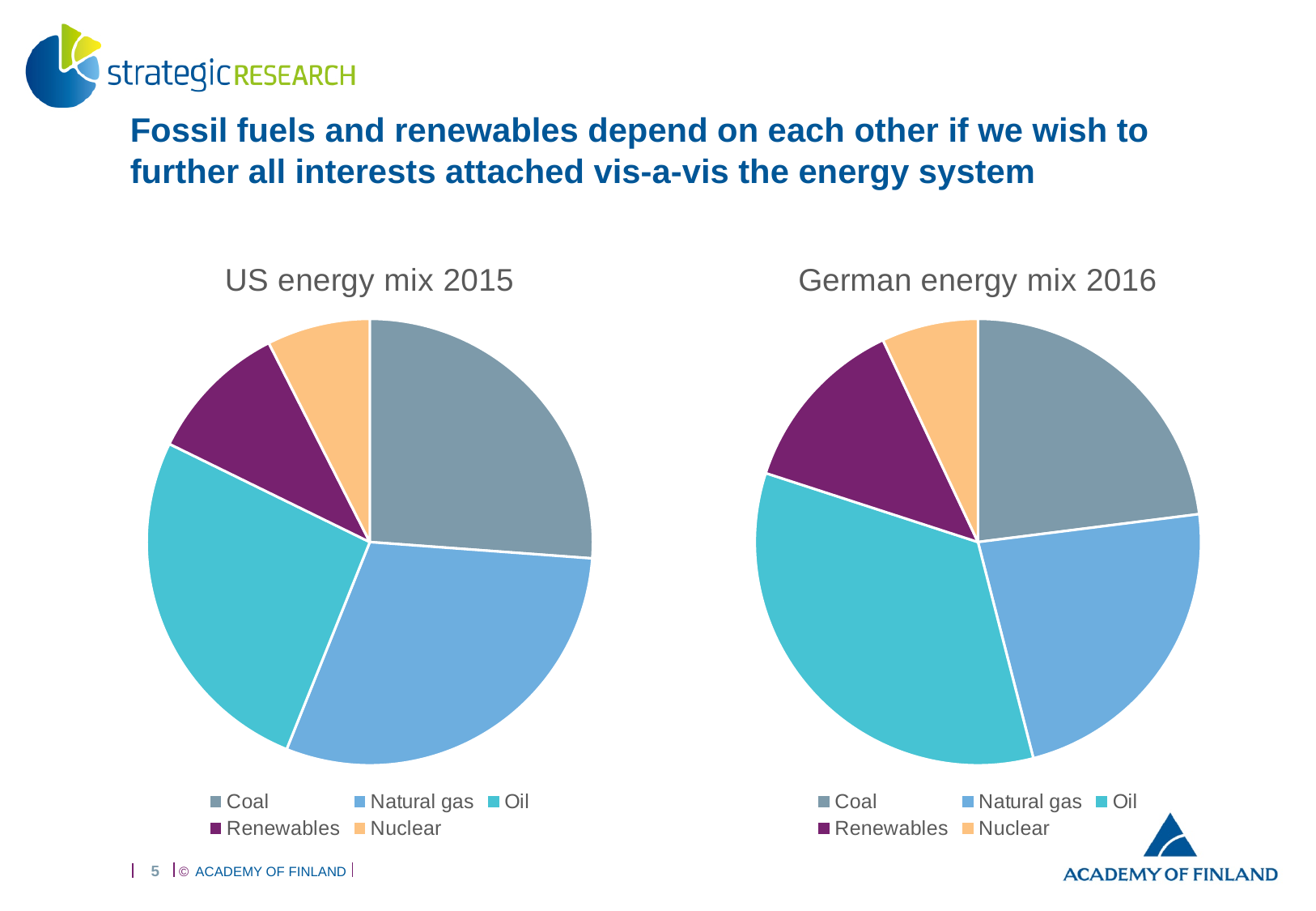
In the "German energy mix 2016" chart, which energy source has the smallest slice? Nuclear In the "German energy mix 2016" chart, which slice is larger: Oil or Coal? Oil In the "German energy mix 2016" chart, which slice is larger: Renewables or Nuclear? Renewables In the "US energy mix 2015" chart, which energy source is shown in orange? Nuclear In the "US energy mix 2015" chart, which energy source has the smallest slice? Nuclear What is the title of the pie chart on the left side of the slide? US energy mix 2015 What kind of chart is the "German energy mix 2016" chart? Pie chart How many slices does the "US energy mix 2015" pie chart have? 5 What kind of chart is the "US energy mix 2015" chart? Pie chart In the "US energy mix 2015" chart, which slice is larger: Coal or Renewables? Coal In the "German energy mix 2016" chart, which energy source has the largest slice? Oil How many entries does the legend of the "German energy mix 2016" chart list? 5